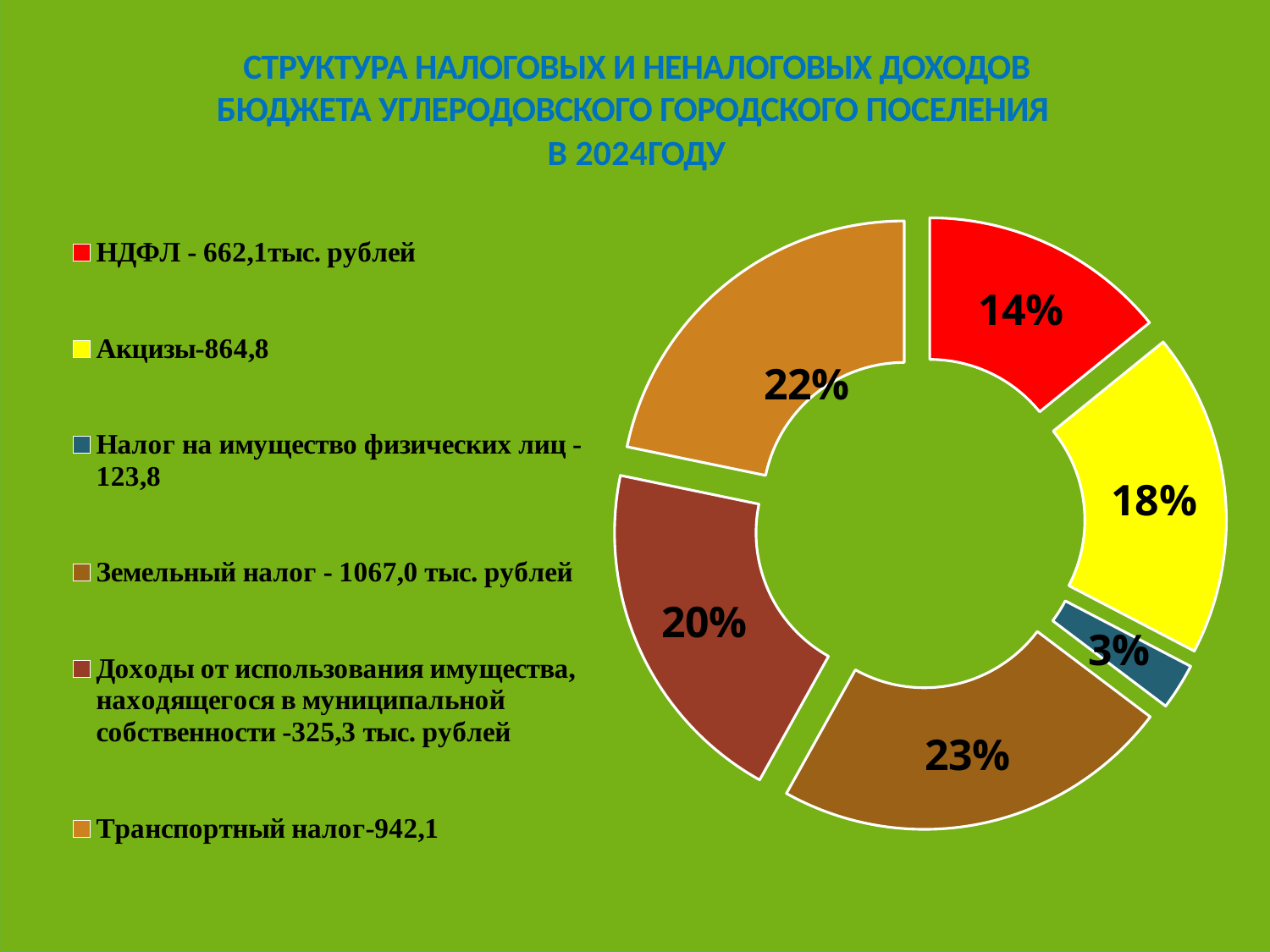
What share of the chart does Земельный налог represent? 23% Which has a larger share: Акцизы or Транспортный налог? Транспортный налог What colour is the slice for Акцизы? Yellow What is the difference in percentage points between the shares of Земельный налог and НДФЛ? 9 What kind of chart is shown on the slide? Doughnut (pie) chart How many categories are shown in the chart? 6 Which category has the smallest share of the chart? Налог на имущество физических лиц What share of the chart does Транспортный налог represent? 22% Which category has the largest share of the chart? Земельный налог What share of the chart does Акцизы represent? 18%